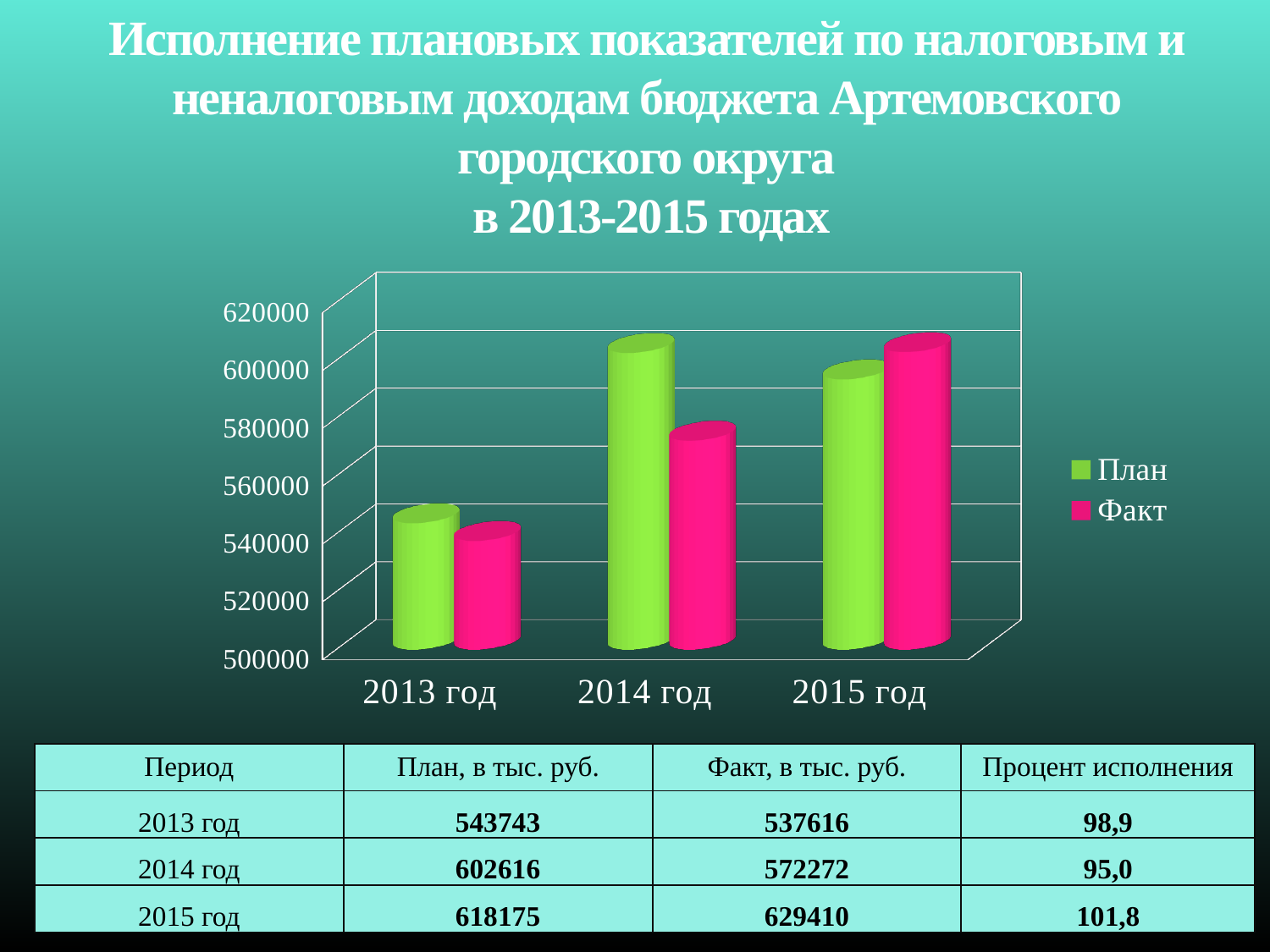
In 2014 год, which is larger, План or Факт? План How many series does the chart legend list? 2 What is the План value for 2013 год? 543743 Is the Факт value for 2015 год greater or less than 580000? greater What are the two series named in the chart legend? План and Факт Which year has the highest Факт bar? 2015 год What colour are the Факт bars in the chart? pink What is the Факт value for 2014 год? 572272 How many year categories are shown on the x axis of the chart? 3 Do the Факт values rise or fall from 2013 год to 2015 год? rise What kind of chart is shown on the slide? bar chart Which year has the lowest План bar? 2013 год